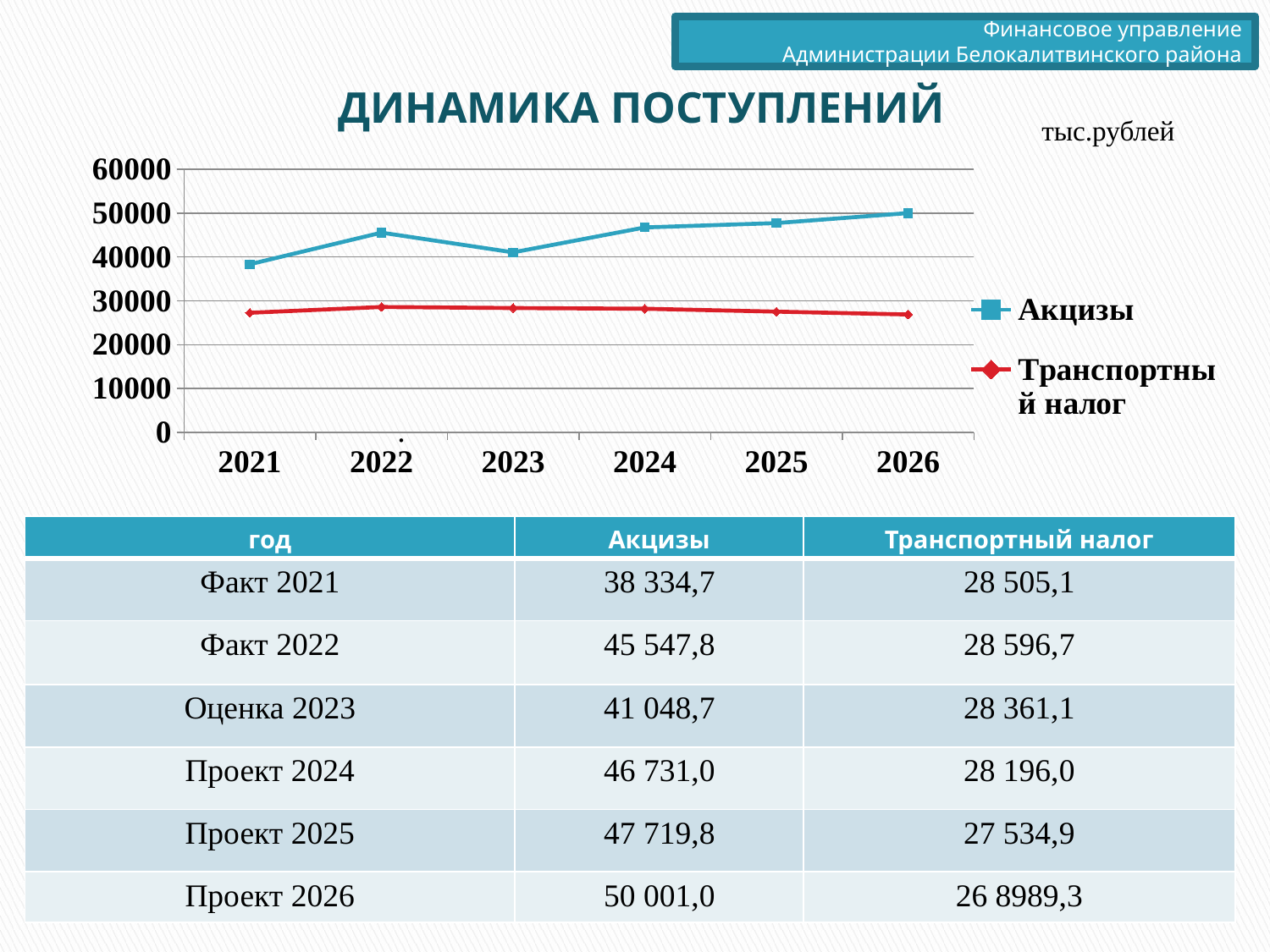
What is the difference between the Акцизы value for 2026 and for 2021? 11 666,3 What is the value of Акцизы for 2022? 45 547,8 In 2023, which series has the larger value, Акцизы or Транспортный налог? Акцизы How many series does the chart legend list? 2 Is the Акцизы value for 2021 greater or less than 40000? less What is the value of Транспортный налог for 2024? 28 196,0 Does the Транспортный налог line rise or fall from 2022 to 2026? fall In which year is the Акцизы value lowest? 2021 What type of chart is shown on the slide? line chart In which year is the Акцизы value highest? 2026 Is the Транспортный налог value for 2025 greater or less than 30000? less How many years are plotted on the x axis of the chart? 6